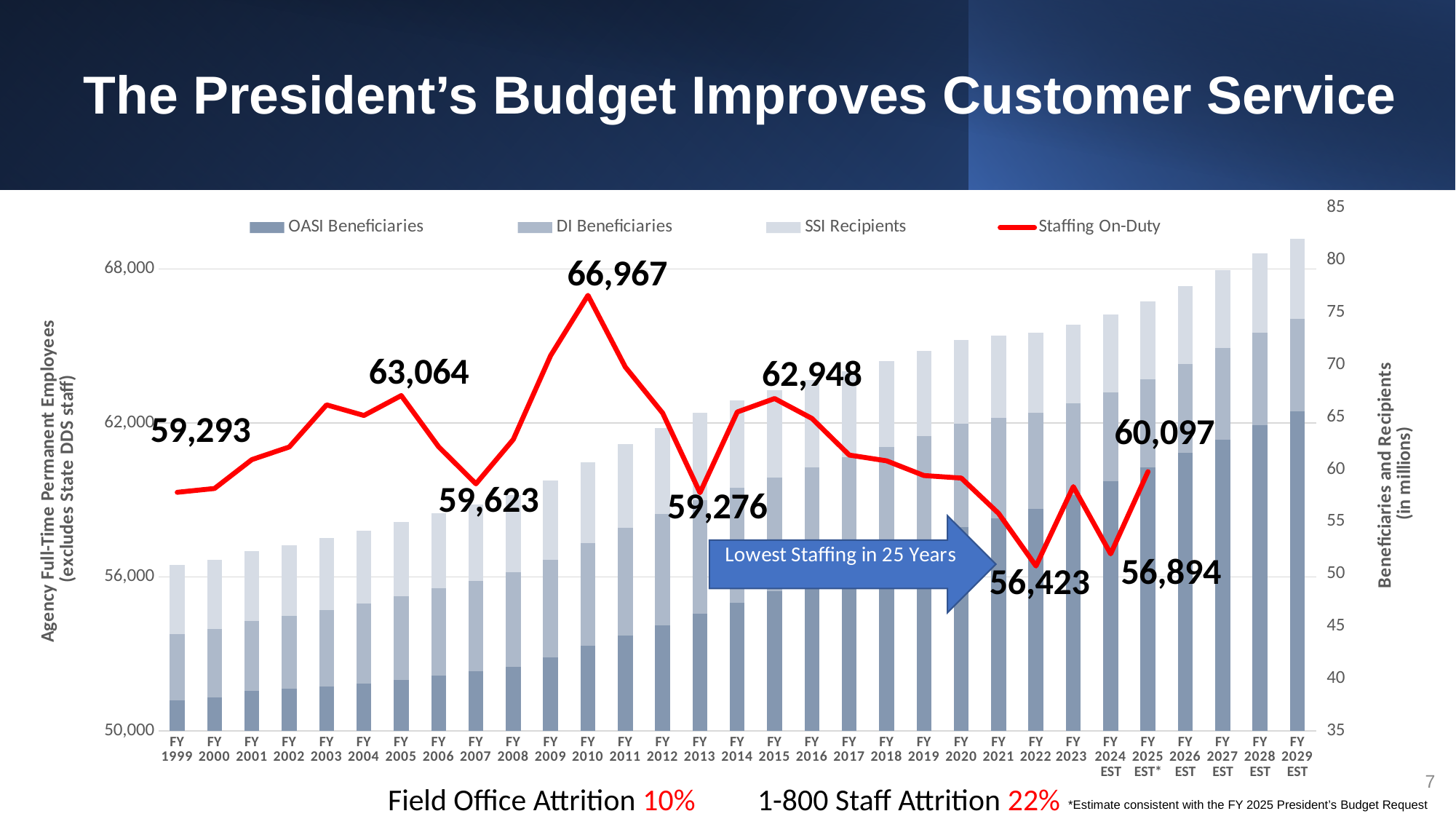
What kind of chart is shown on the slide? A combination stacked bar and line chart What is the Staffing On-Duty value for FY 2010? 66,967 What is the Staffing On-Duty value for FY 2025 EST*? 60,097 What is the Staffing On-Duty value for FY 2022? 56,423 By how much does the Staffing On-Duty value for FY 2025 EST* exceed the value for FY 2024 EST? 3,203 In which fiscal year does the Staffing On-Duty line reach its lowest value? FY 2022 How many series does the legend list? 4 Is the Staffing On-Duty value for FY 2009 greater or less than 62,000? greater In which fiscal year does the Staffing On-Duty line reach its highest value? FY 2010 Which has the larger Staffing On-Duty value, FY 2005 or FY 2015? FY 2005 What is the difference between the Staffing On-Duty values for FY 2010 and FY 2022? 10,544 How many fiscal years are shown on the x axis? 31